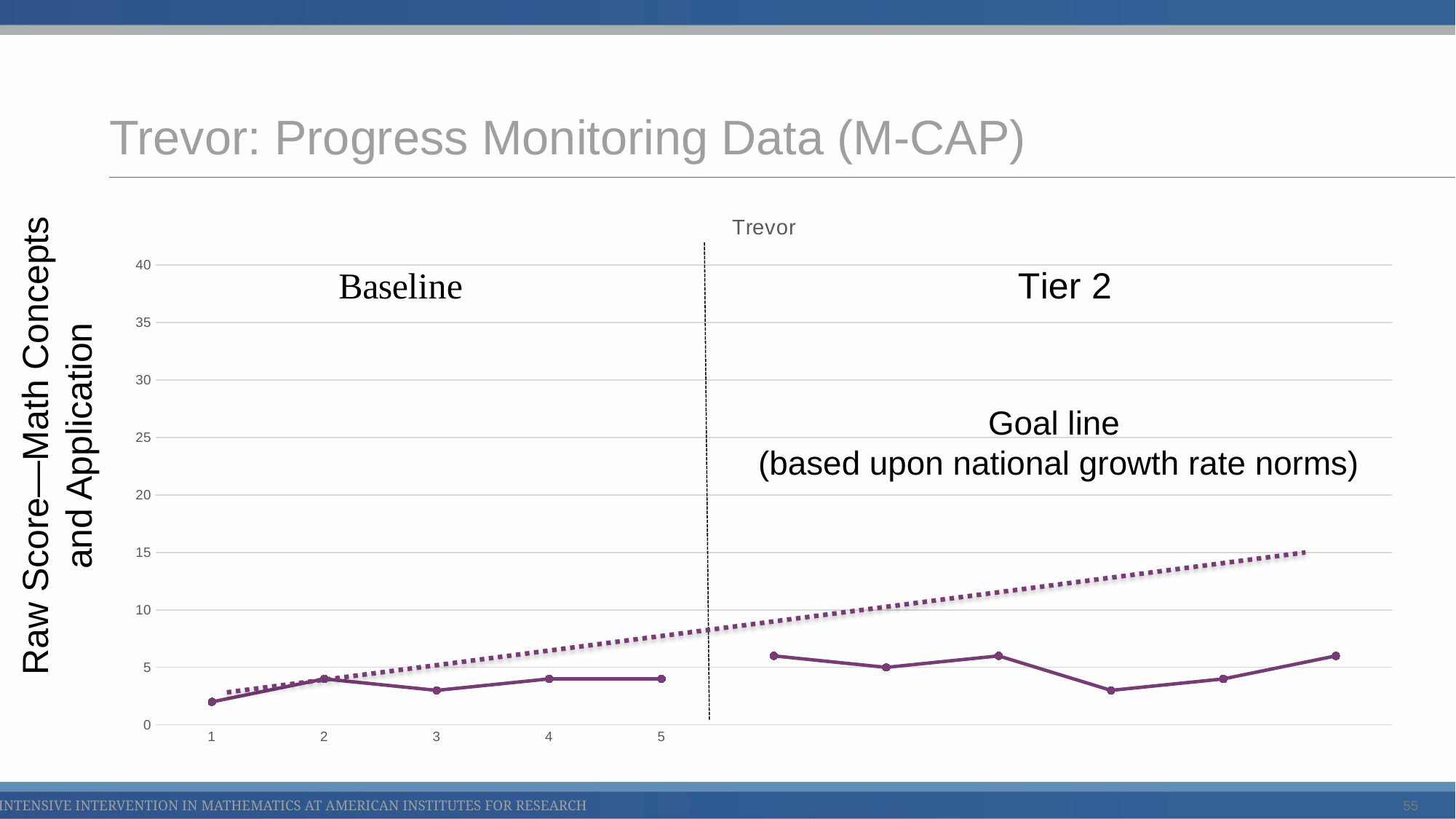
What is the highest value shown on the y axis? 40 At which x-axis label is the lowest value on the solid line? 1 Is the value at x = 3 greater or less than 5? less How many x-axis labels are printed on the chart? 5 Does the dotted goal line rise or fall from left to right? rise Which is larger, the value at x = 1 or the value at x = 2? x = 2 Is the right end of the dotted goal line greater or less than 10? greater What is the title printed above the chart? Trevor Is the value at x = 1 greater or less than 5? less What kind of chart is shown on the slide? line chart What are the two phases labeled on the chart? Baseline and Tier 2